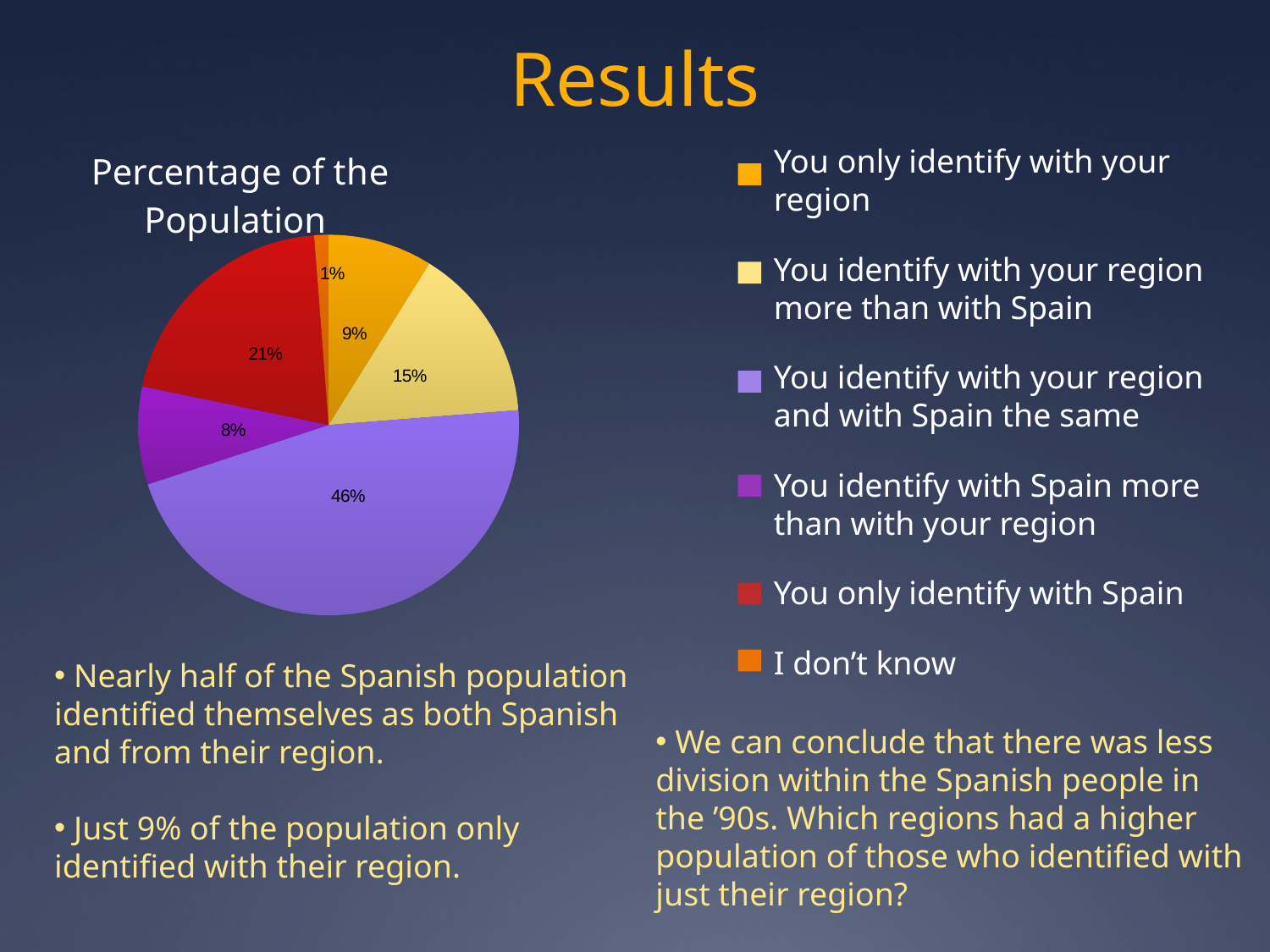
What is the title of the chart? Percentage of the Population Which category has the smallest share of the pie? I don't know Which is larger: the share that identifies with Spain more than with their region, or the share that identifies with their region more than with Spain? You identify with your region more than with Spain What percentage of the population only identifies with their region? 9% What is the difference between the share that only identifies with Spain and the share that only identifies with their region? 12% Which category has the largest share of the pie? You identify with your region and with Spain the same What percentage of the population only identifies with Spain? 21% What percentage of the population identifies with their region and with Spain the same? 46% How many categories does the legend list? 6 What percentage of the population answered 'I don't know'? 1% What type of chart is shown on the slide? pie chart What percentage of the population identifies with their region more than with Spain? 15%